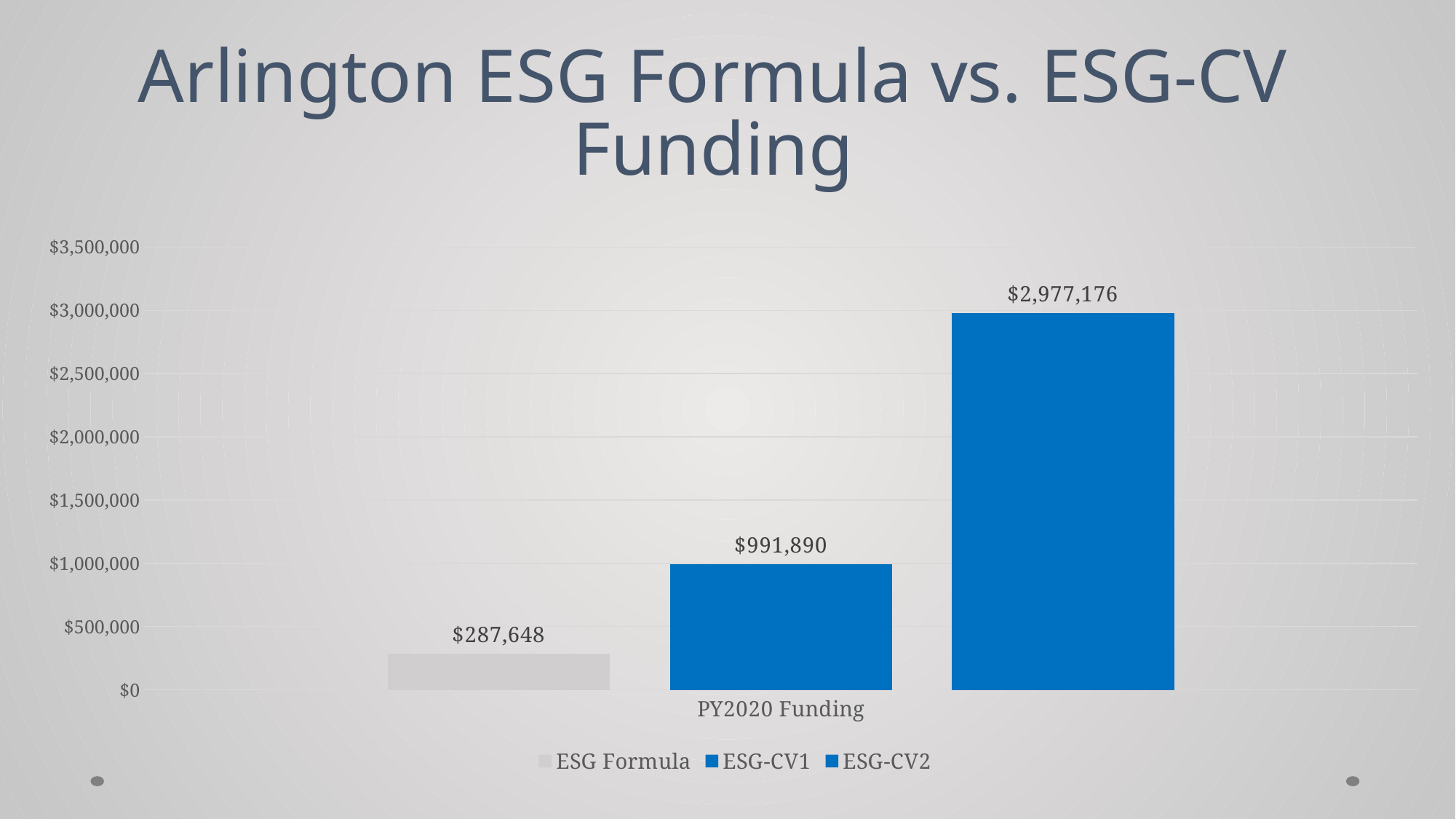
Which series has the lowest PY2020 Funding value? ESG Formula What is the difference between the ESG-CV2 and ESG-CV1 values? $1,985,286 What kind of chart is shown on the slide? Bar chart What is the value for ESG Formula in PY2020 Funding? $287,648 Is the value for ESG-CV2 greater or less than $2,500,000? greater Which series has the highest PY2020 Funding value? ESG-CV2 What is the value for ESG-CV2 in PY2020 Funding? $2,977,176 What is the difference between the ESG-CV1 and ESG Formula values? $704,242 Which is larger, the ESG Formula value or the ESG-CV1 value? ESG-CV1 What is the value for ESG-CV1 in PY2020 Funding? $991,890 What is the title of the chart on the slide? Arlington ESG Formula vs. ESG-CV Funding How many series does the legend list? 3